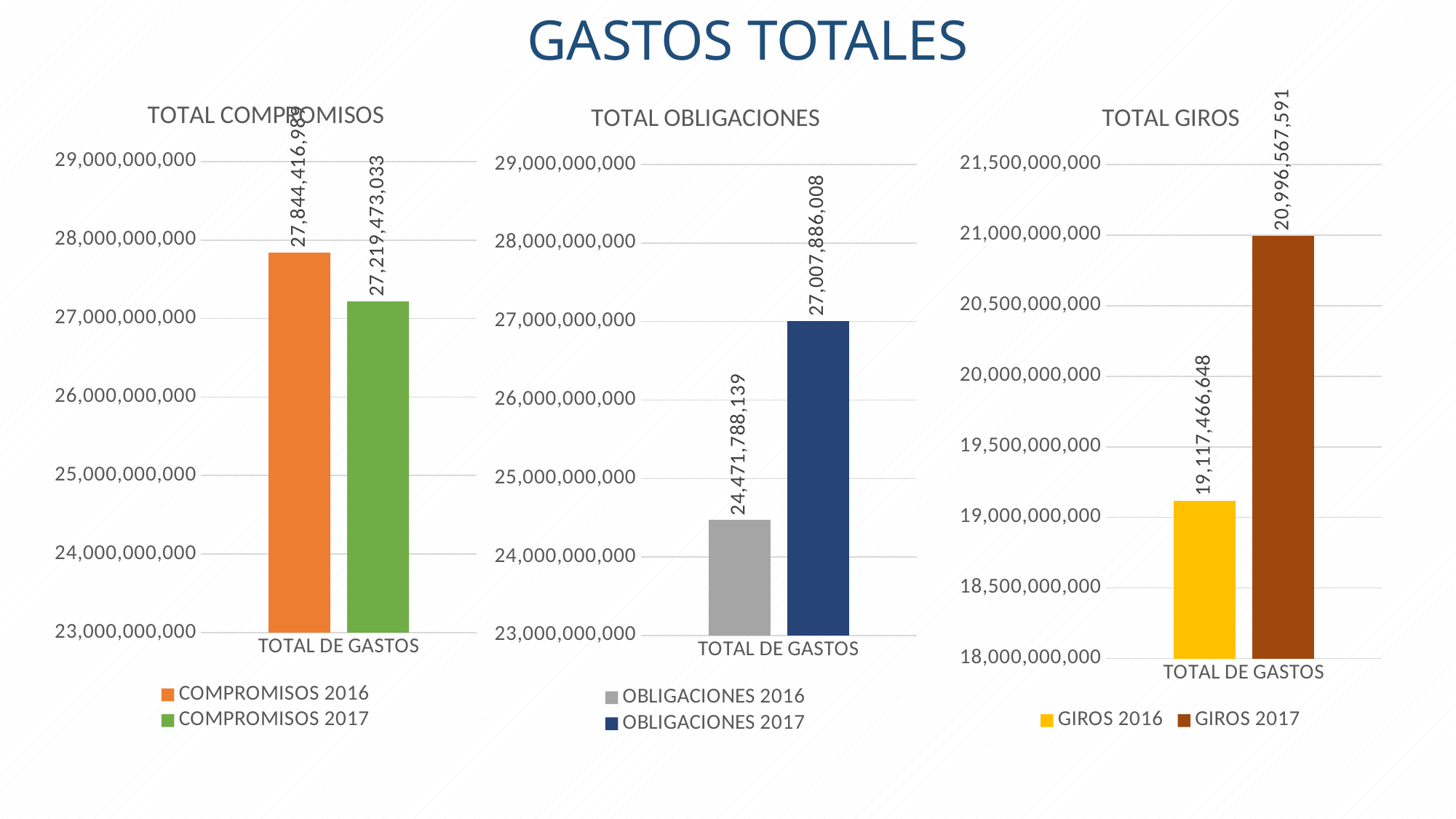
In the TOTAL COMPROMISOS chart, which series has the higher value, COMPROMISOS 2016 or COMPROMISOS 2017? COMPROMISOS 2016 In the TOTAL GIROS chart, what is the value for GIROS 2016? 19,117,466,648 What type of chart is the TOTAL OBLIGACIONES chart? bar chart In the TOTAL GIROS chart, is the value for GIROS 2016 greater or less than 19,500,000,000? less In the TOTAL COMPROMISOS chart, what is the value for COMPROMISOS 2017? 27,219,473,033 In the TOTAL OBLIGACIONES chart, what is the difference between OBLIGACIONES 2017 and OBLIGACIONES 2016? 2,536,097,869 How many series does the legend of the TOTAL GIROS chart list? 2 In the TOTAL OBLIGACIONES chart, what is the value for OBLIGACIONES 2017? 27,007,886,008 In the TOTAL GIROS chart, what is the value for GIROS 2017? 20,996,567,591 In the TOTAL OBLIGACIONES chart, what is the value for OBLIGACIONES 2016? 24,471,788,139 In the TOTAL GIROS chart, what is the difference between GIROS 2017 and GIROS 2016? 1,879,100,943 In the TOTAL OBLIGACIONES chart, which series has the lowest value? OBLIGACIONES 2016